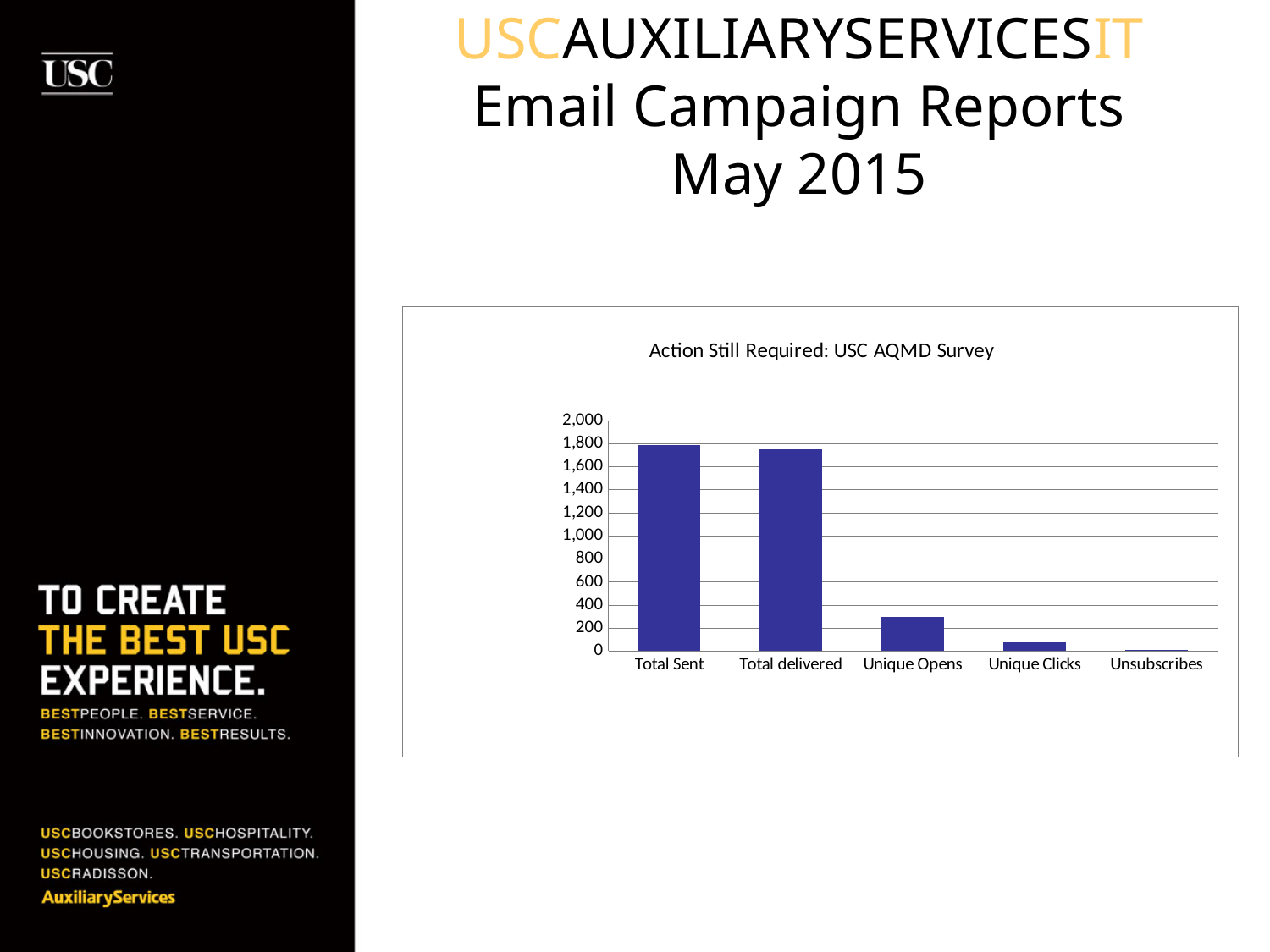
Is the value for Total delivered greater or less than 1,600? greater Is the value for Unique Clicks greater or less than 200? less Which is larger, the value for Unique Opens or the value for Unique Clicks? Unique Opens Do the values rise or fall moving from left to right along the x axis? fall Which category has the lowest value in the chart? Unsubscribes What kind of chart is shown on the slide? bar chart Which is larger, the value for Total Sent or the value for Unique Opens? Total Sent What is the title of the chart? Action Still Required: USC AQMD Survey Is the value for Unique Opens greater or less than 200? greater How many categories are shown on the x axis of the chart? 5